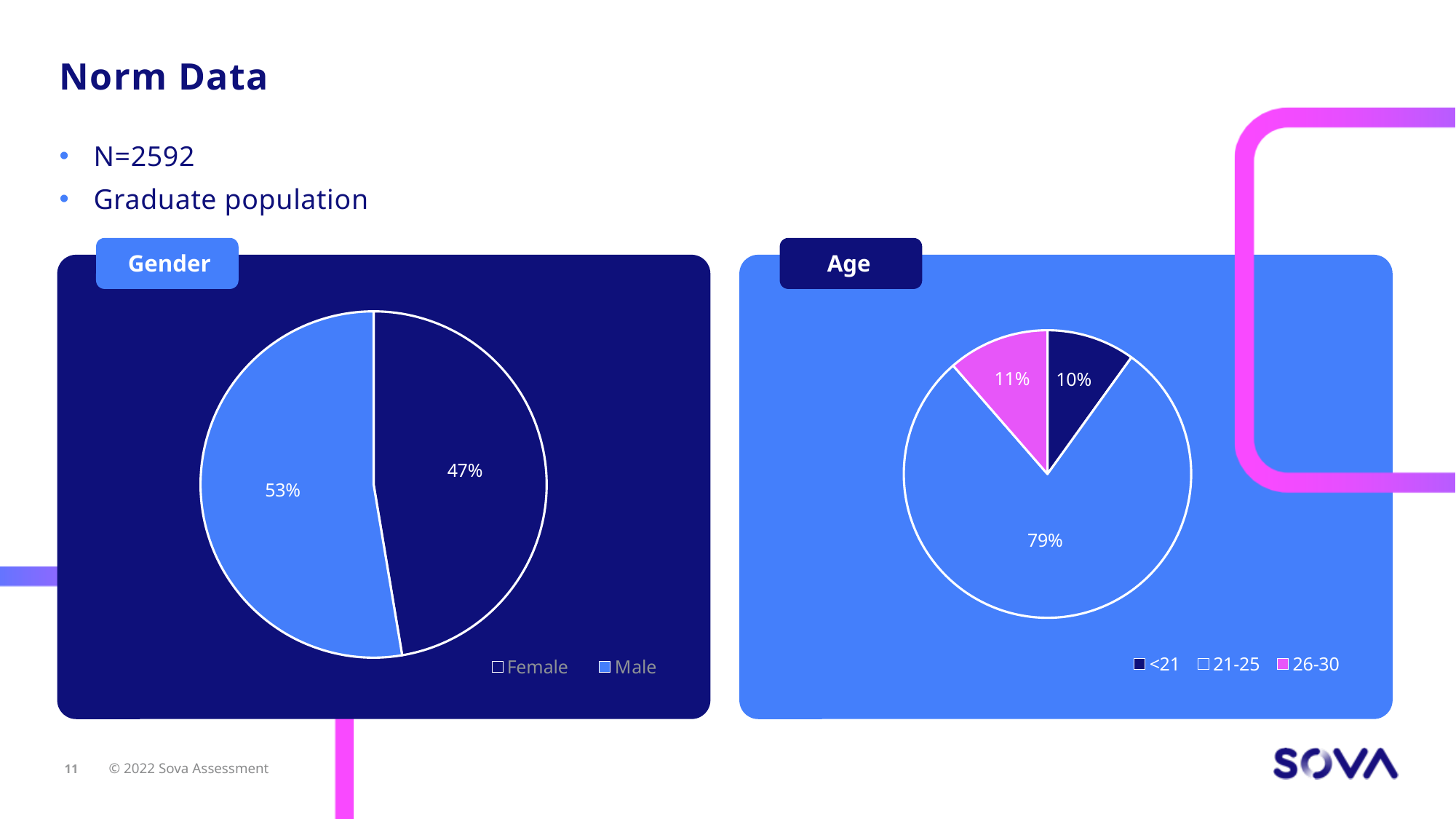
In the Age chart, what percentage is the <21 group? 10% In the Age chart, what colour is the 26-30 slice? Magenta (pink) In the Gender chart, what is the difference between the Male and Female percentages? 6% What type of chart is the Age chart? Pie chart In the Age chart, which age group has the largest share? 21-25 In the Gender chart, what percentage is Female? 47% In the Age chart, which age group has the smallest share? <21 In the Age chart, how many age groups are shown? 3 In the Gender chart, what percentage is Male? 53% In the Age chart, what percentage is the 21-25 group? 79% In the Age chart, what percentage is the 26-30 group? 11% In the Gender chart, which is larger, Female or Male? Male